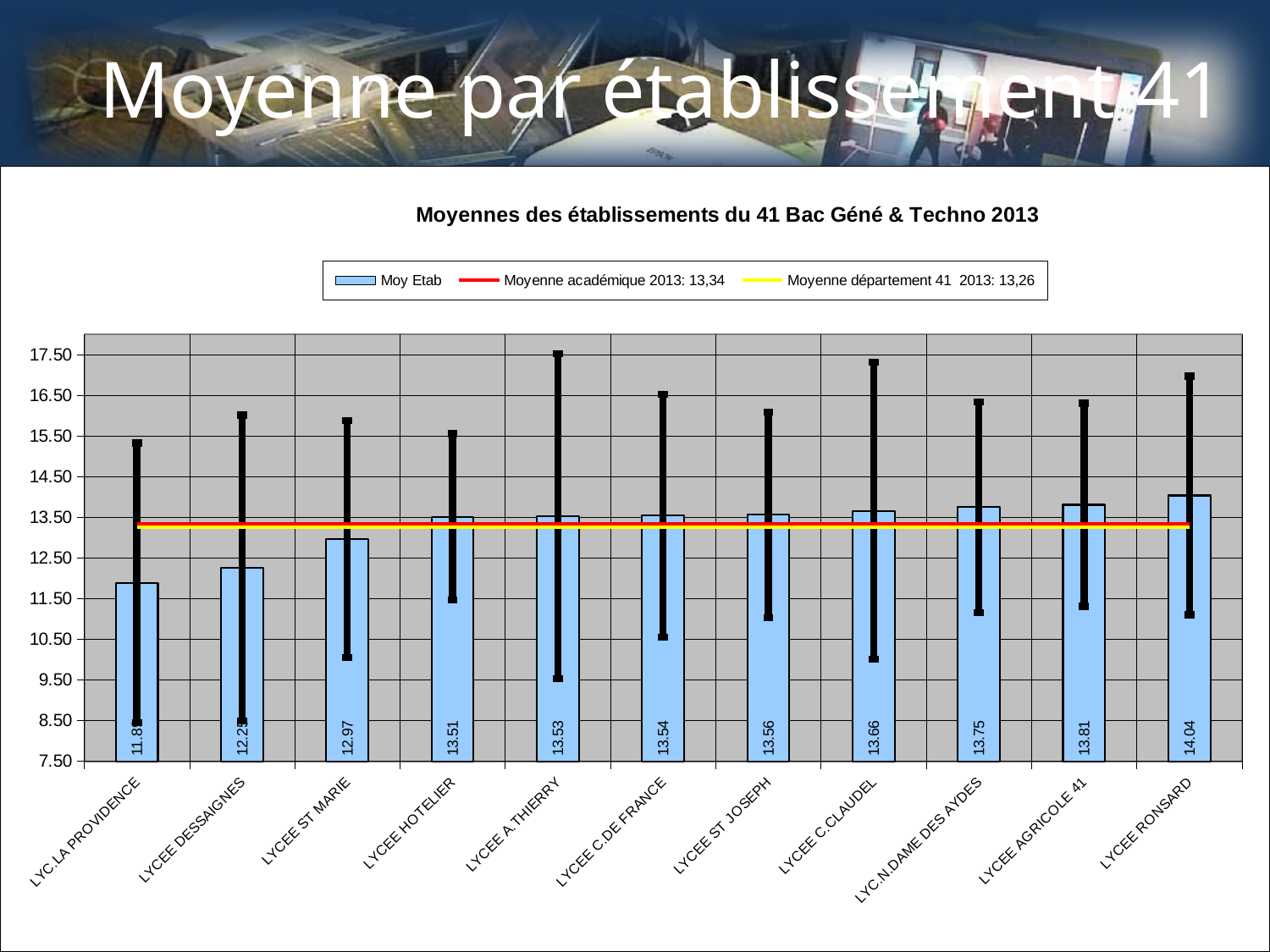
What kind of chart is this? bar chart What is the value for LYC.N.DAME DES AYDES? 13.75 Which establishment has the lowest average? LYC.LA PROVIDENCE Do the bar values rise or fall from left to right along the x axis? rise Which has a higher value, LYCEE AGRICOLE 41 or LYCEE C.CLAUDEL? LYCEE AGRICOLE 41 What is the value for LYCEE ST MARIE? 12.97 Is the value for LYC.LA PROVIDENCE greater or less than 12.50? less How many entries does the legend list? 3 How many establishments are shown on the x axis? 11 What is the value for LYCEE RONSARD? 14.04 What is the difference between the values for LYCEE RONSARD and LYCEE ST MARIE? 1.07 Which establishment has the highest average? LYCEE RONSARD